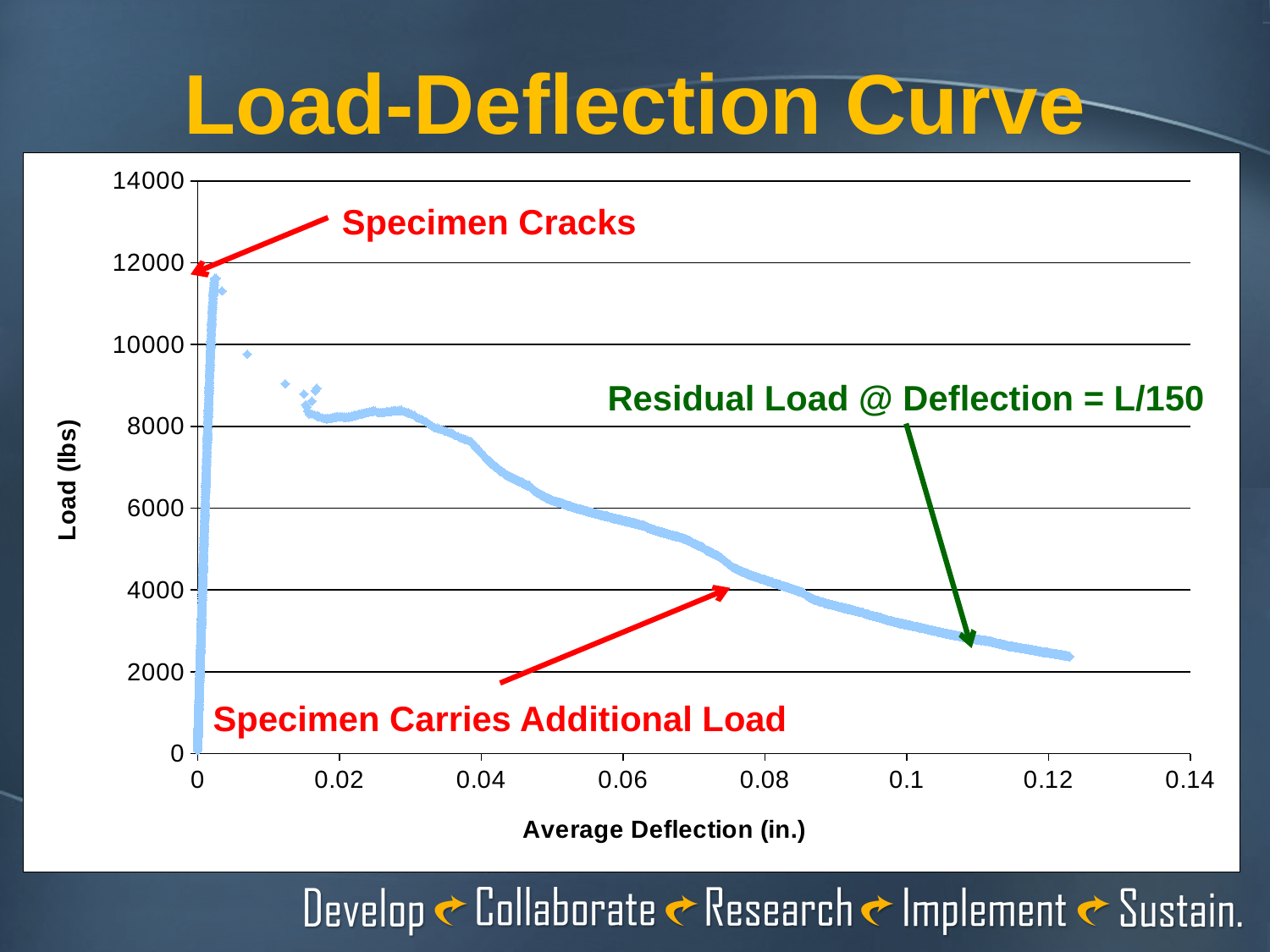
What is the highest value shown on the horizontal axis? 0.14 After the specimen cracks, does the load rise or fall as the average deflection increases? fall What is the title of the chart? Load-Deflection Curve Is the load at a deflection of 0.02 in. larger or smaller than the load at a deflection of 0.1 in.? larger Is the peak load reached by the specimen greater or less than 12000 lbs? less What type of chart is shown on the slide? Scatter chart Is the load at an average deflection of 0.08 in. greater or less than 6000 lbs? less Is the load at an average deflection of 0.04 in. greater or less than 6000 lbs? greater What is the label of the vertical axis? Load (lbs)